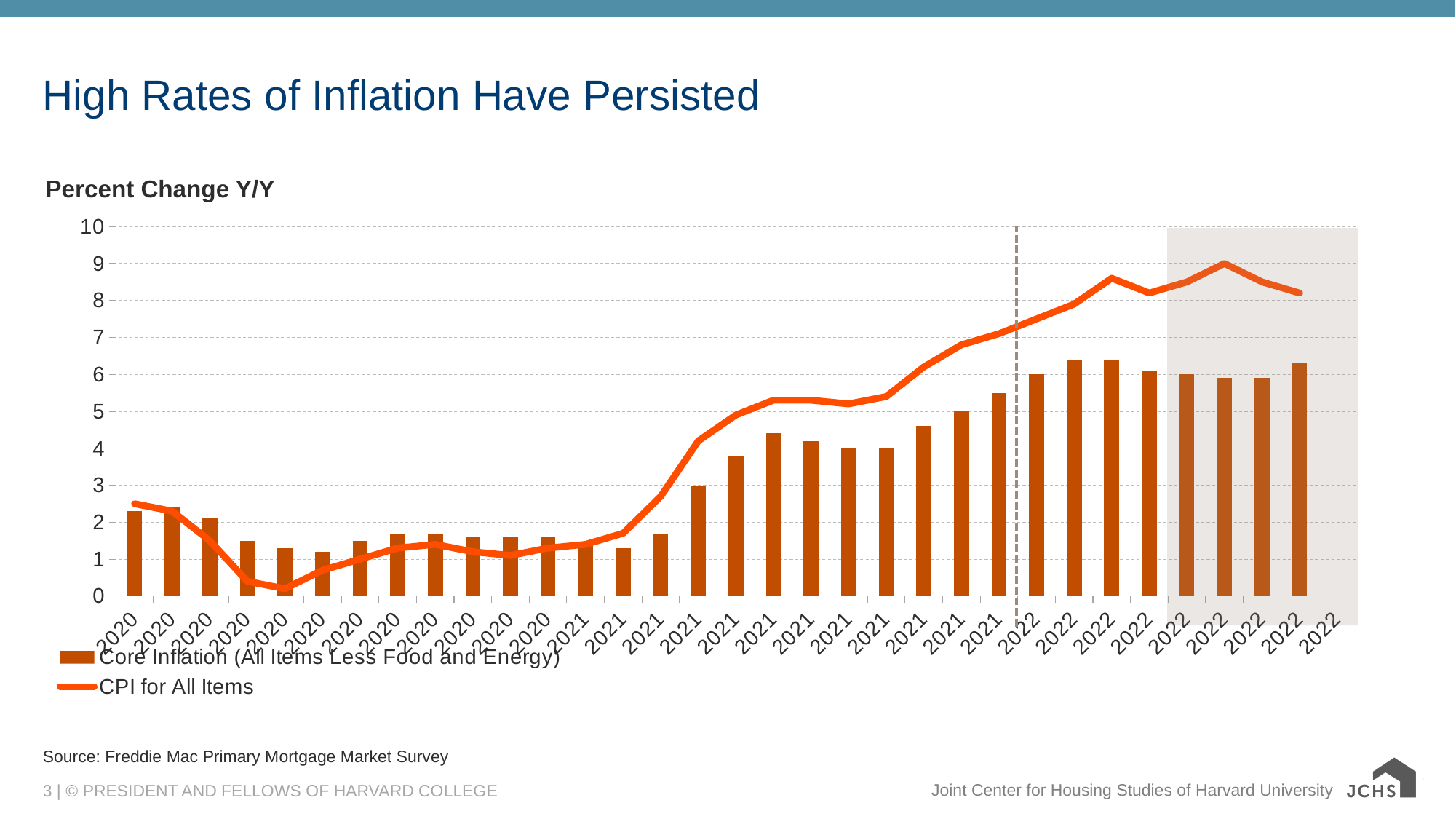
Is the first Core Inflation bar (leftmost, 2020) greater or less than 3? less In 2022, which series is higher: CPI for All Items or Core Inflation (All Items Less Food and Energy)? CPI for All Items How many series does the legend list? 2 Which series is shown as a line rather than bars? CPI for All Items Which series reaches the highest value on the chart? CPI for All Items What kind of chart is shown on the slide? Combined bar and line chart What is the title of the slide's chart? High Rates of Inflation Have Persisted Does the CPI for All Items line generally rise or fall from the start of 2021 to the end of the chart? rise Is the last Core Inflation bar (rightmost, 2022) greater or less than 5? greater How many distinct years are labeled on the x axis? 3 Is the peak of the CPI for All Items line greater or less than 8? greater